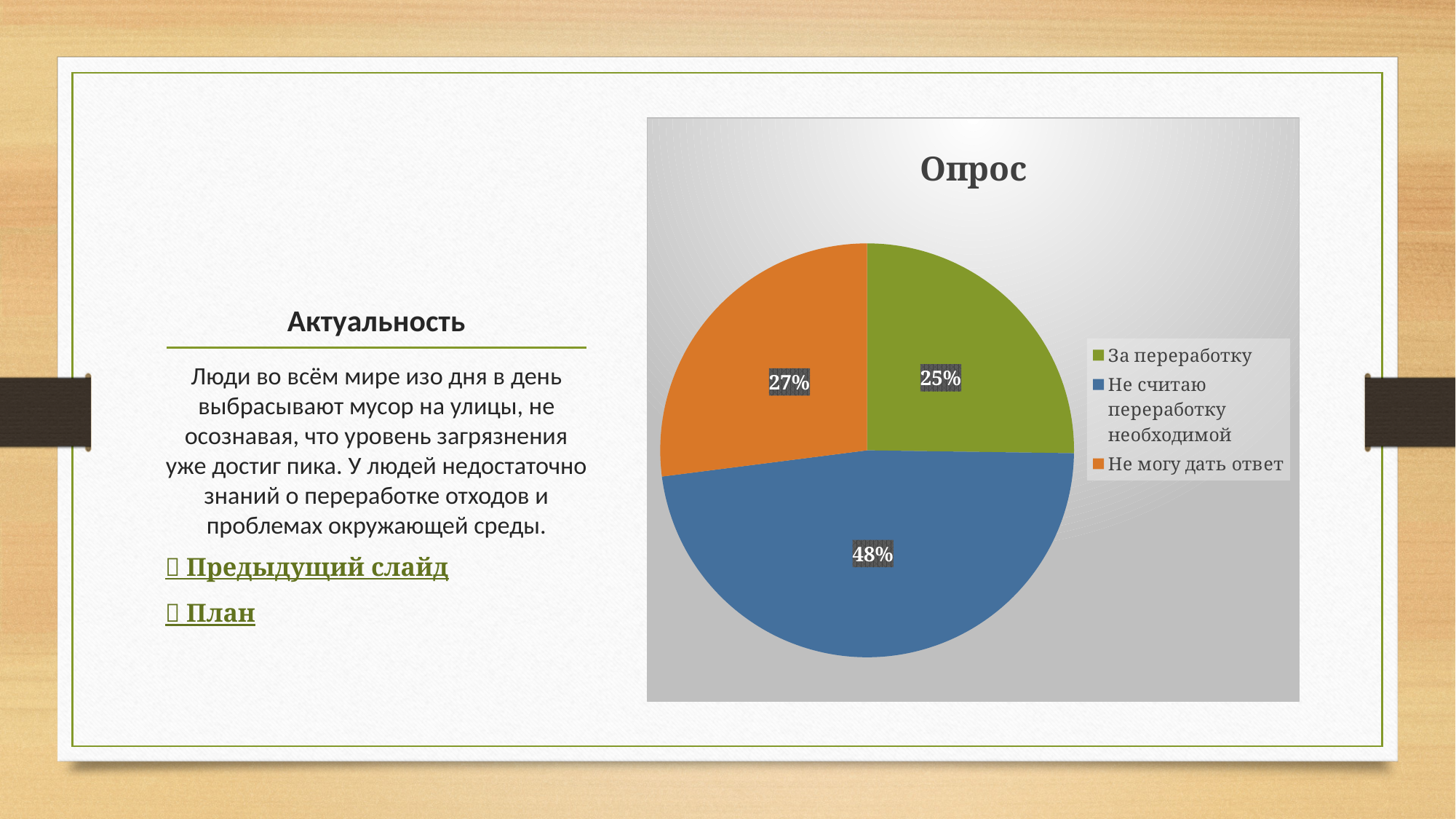
Which is larger: the share for 'Не могу дать ответ' or the share for 'За переработку'? Не могу дать ответ Which category has the largest share of the pie? Не считаю переработку необходимой What type of chart is shown on the slide? pie chart What colour is the slice for 'Не считаю переработку необходимой'? blue What percentage of the pie is labelled 'Не могу дать ответ'? 27% Which category has the smallest share of the pie? За переработку What is the title of the chart? Опрос What is the difference between the shares for 'Не считаю переработку необходимой' and 'За переработку'? 23% What percentage of the pie is labelled 'За переработку'? 25% How many slices does the pie chart have? 3 What percentage of the pie is labelled 'Не считаю переработку необходимой'? 48% How many entries does the legend list? 3